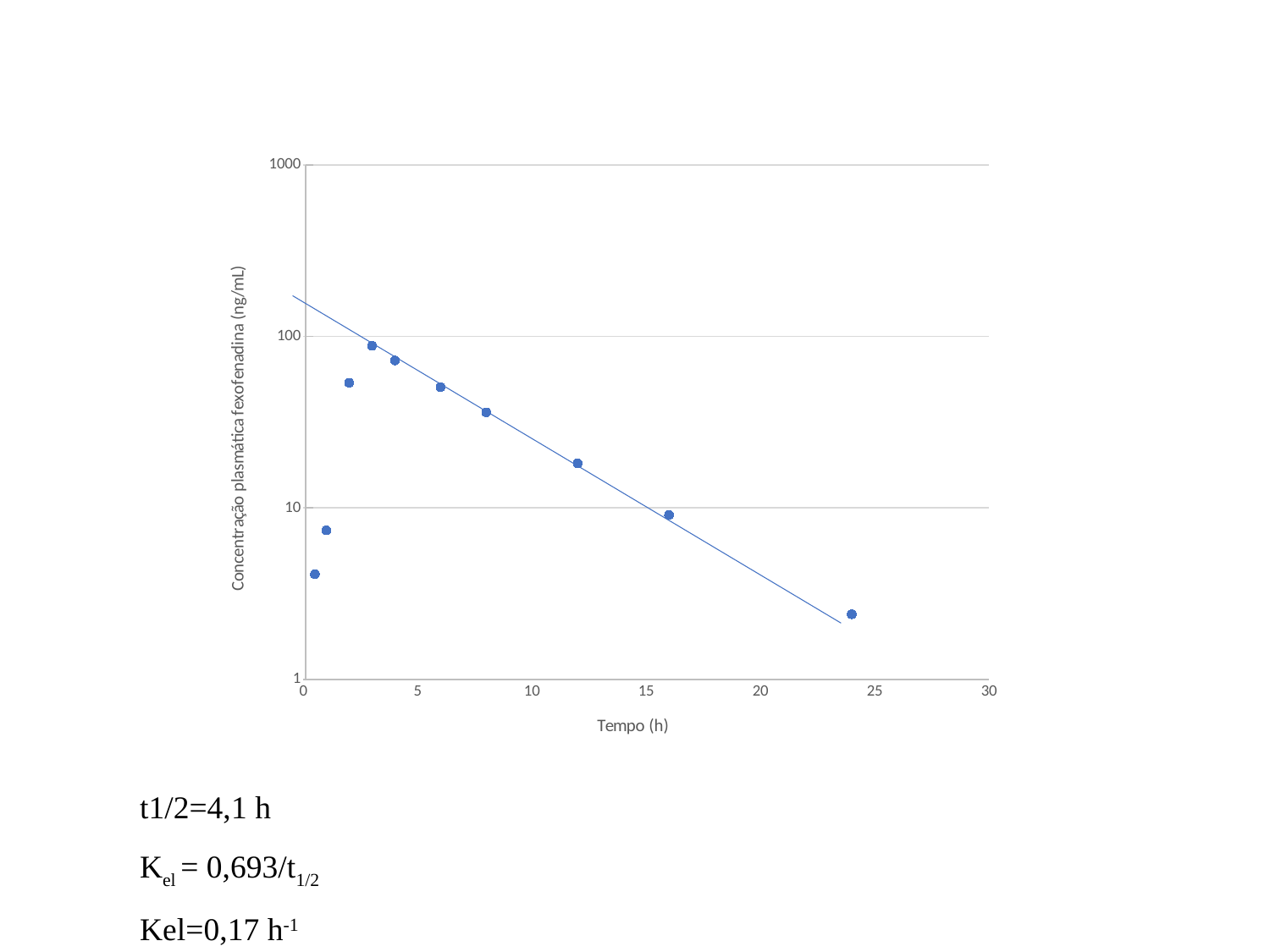
How many data points are plotted on the chart? 10 Is the plasma concentration at 3 h greater or less than 100 ng/mL? less At which time point is the plasma concentration lowest? 24 h What is the title of the y axis of the chart? Concentração plasmática fexofenadina (ng/mL) Is the plasma concentration at 12 h greater or less than 10 ng/mL? greater Which is larger, the plasma concentration at 4 h or at 16 h? 4 h Is the plasma concentration at 24 h greater or less than 10 ng/mL? less What is the title of the x axis of the chart? Tempo (h) At which time point is the plasma concentration highest? 3 h What kind of chart is shown on the slide? scatter chart After the peak at 3 h, do the plasma concentrations rise or fall as time increases? fall